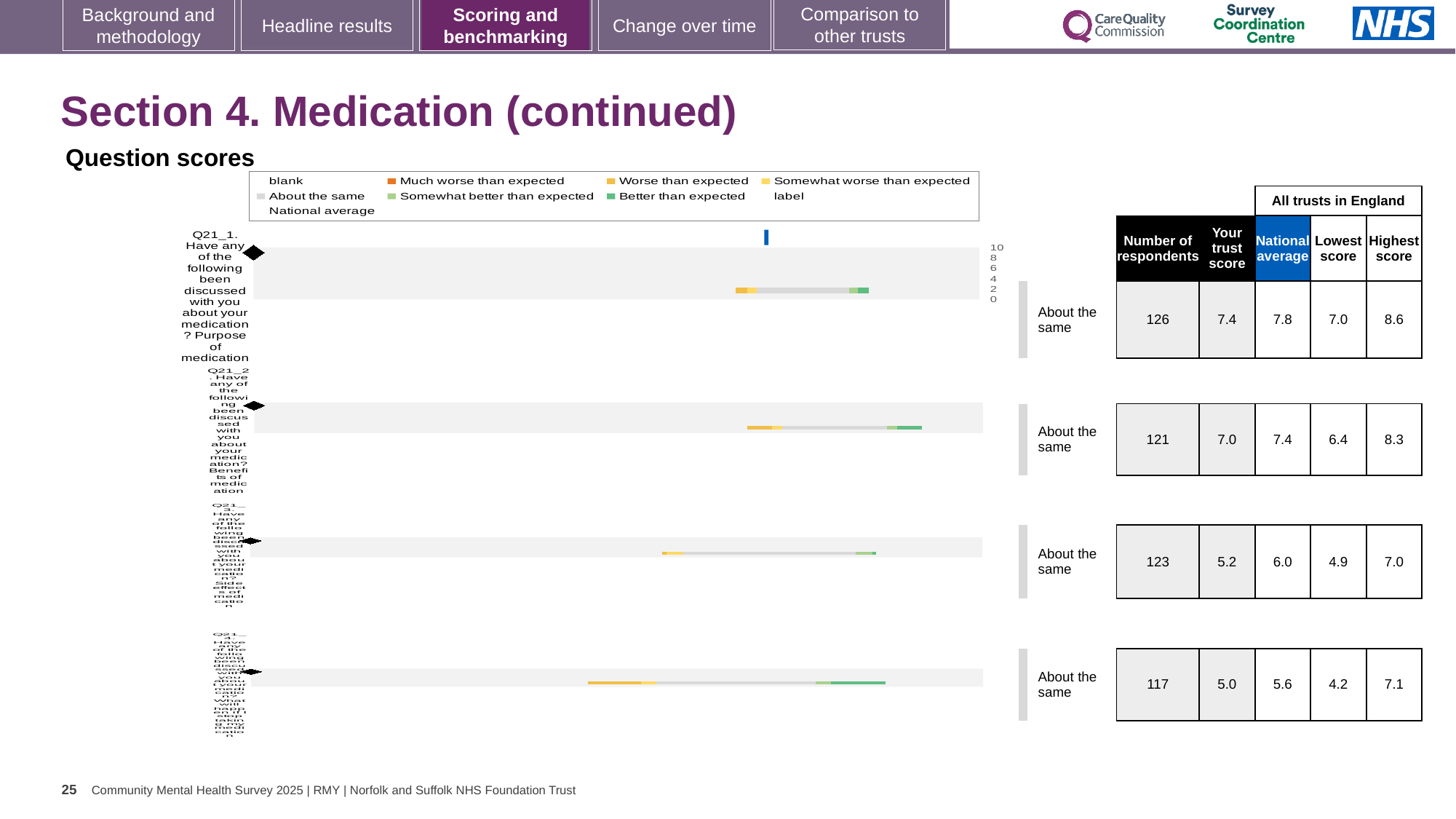
In the table beside the chart, what is the national average for Q21_2 (Benefits of medication)? 7.4 Which question has the fewest respondents in the table beside the chart? Q21_4 Which question has the highest 'Your trust score' in the table beside the chart? Q21_1 How many questions (bars) are plotted in the question scores chart? 4 For Q21_3, which is larger: the trust score or the national average? national average How many entries does the legend of the question scores chart list? 9 What is the difference between the national average and the trust score for Q21_1? 0.4 What kind of chart is used to show the question scores on this slide? bar chart In the table beside the chart, what is the 'Your trust score' for Q21_1 (Purpose of medication)? 7.4 In the table beside the chart, what is the highest score across all trusts in England for Q21_4? 7.1 In the table beside the chart, how many respondents answered Q21_3 (Side effects of medication)? 123 What is the highest value shown on the score axis of the question scores chart? 10